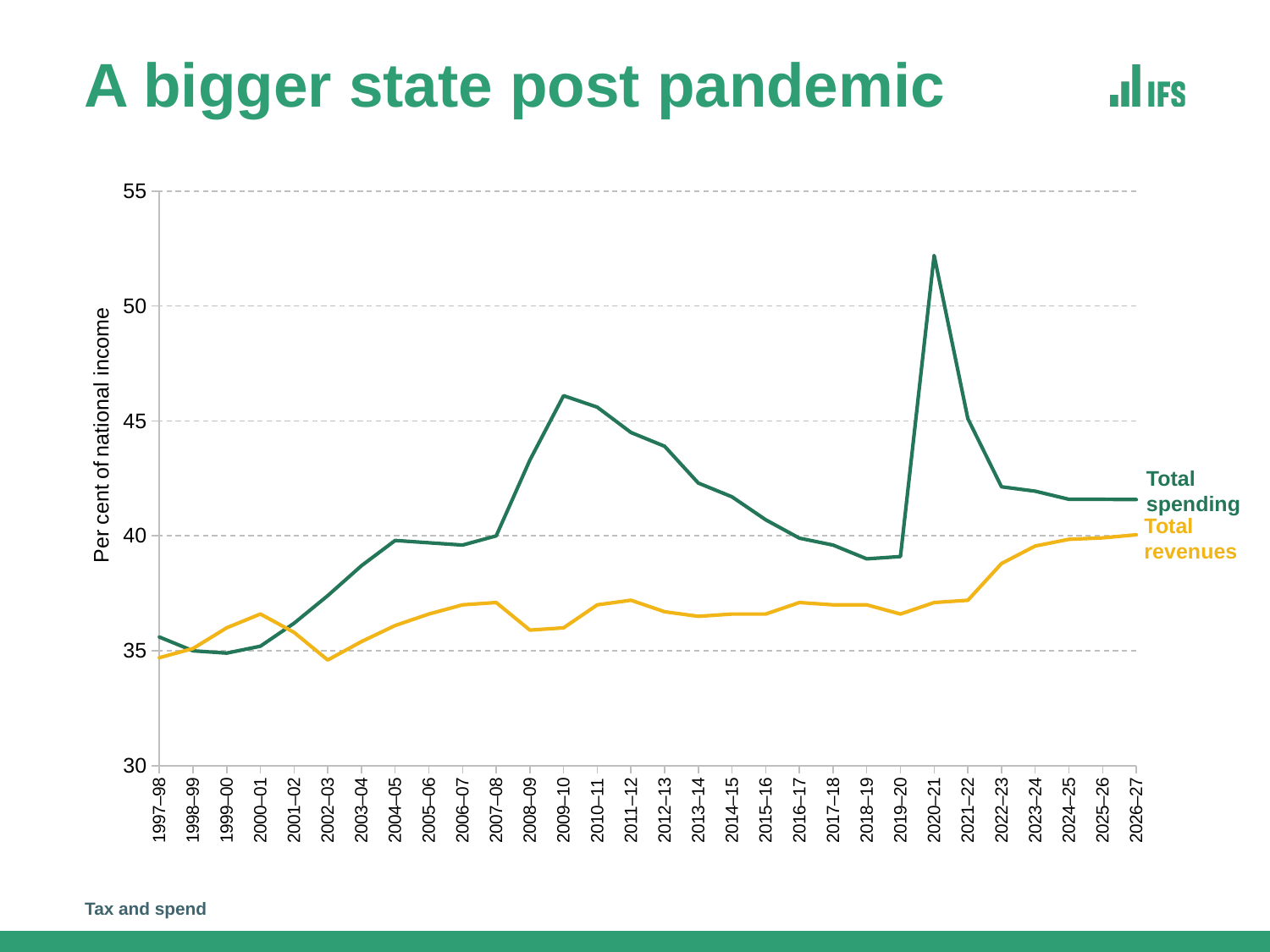
Is the value for Total spending in 2026–27 greater or less than 40? greater In 2020–21, which is larger: Total spending or Total revenues? Total spending Does Total spending rise or fall between 2009–10 and 2018–19? Fall What kind of chart is shown on the slide? Line chart How many series does the chart show? 2 In which year does Total spending reach its highest value? 2020–21 Is the value for Total spending in 2009–10 greater or less than 45? greater In 2000–01, which is larger: Total spending or Total revenues? Total revenues Is the value for Total revenues in 2008–09 greater or less than 40? less How many fiscal years are shown along the x axis? 30 What are the two series plotted on the chart? Total spending and Total revenues